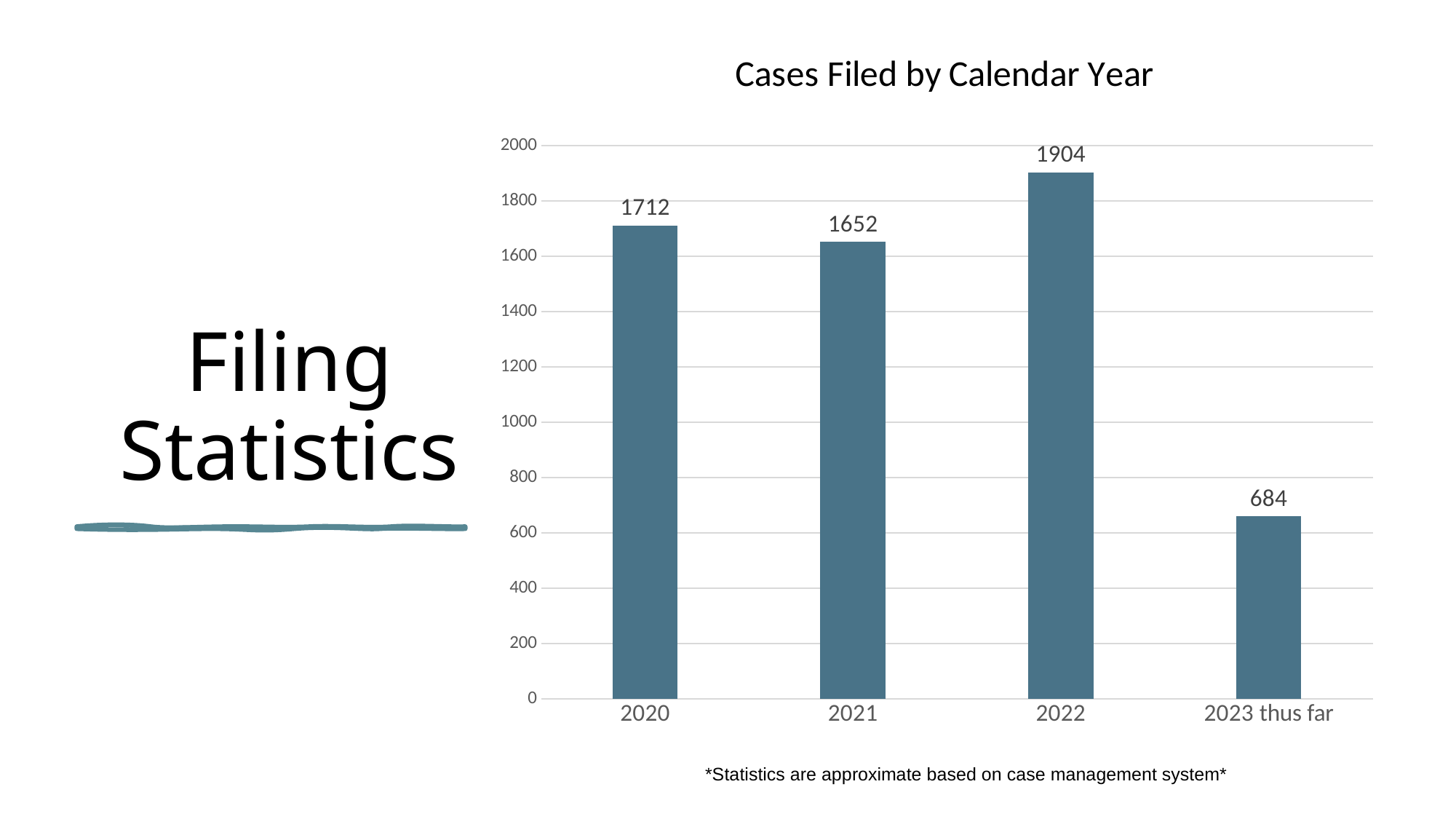
How many categories are shown on the x axis? 4 What is the difference between cases filed in 2020 and 2021? 60 What is the title of the chart? Cases Filed by Calendar Year Which year had more cases filed, 2020 or 2021? 2020 How many cases were filed in 2023 thus far? 684 Which category has the lowest number of cases filed? 2023 thus far What kind of chart is shown on the slide? Bar chart Which year has the highest number of cases filed? 2022 How many cases were filed in 2021? 1652 How many cases were filed in 2020? 1712 How many cases were filed in 2022? 1904 What is the difference between cases filed in 2022 and 2021? 252